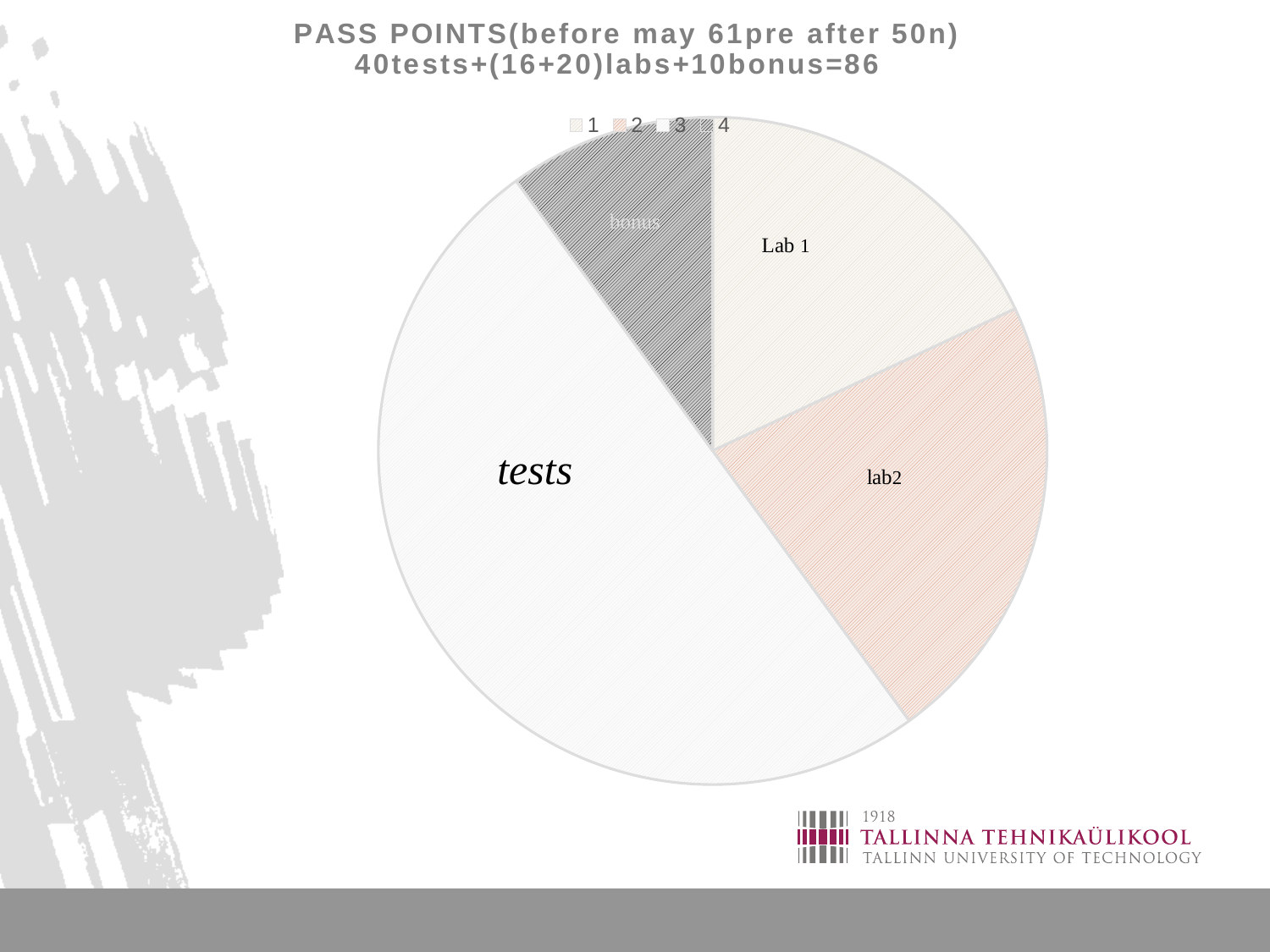
How many entries does the legend of the pie chart list? 4 Which slice of the pie chart is the smallest? bonus How many slices does the pie chart have? 4 What total is given at the end of the chart title's formula? 86 Which slice is larger in the pie chart, Lab 1 or bonus? Lab 1 Which slice is larger in the pie chart, lab2 or Lab 1? lab2 Which slice is larger in the pie chart, tests or lab2? tests What are the labels of the four slices in the pie chart? Lab 1, lab2, tests, bonus What kind of chart is shown on the slide? pie chart Which slice of the pie chart is the largest? tests